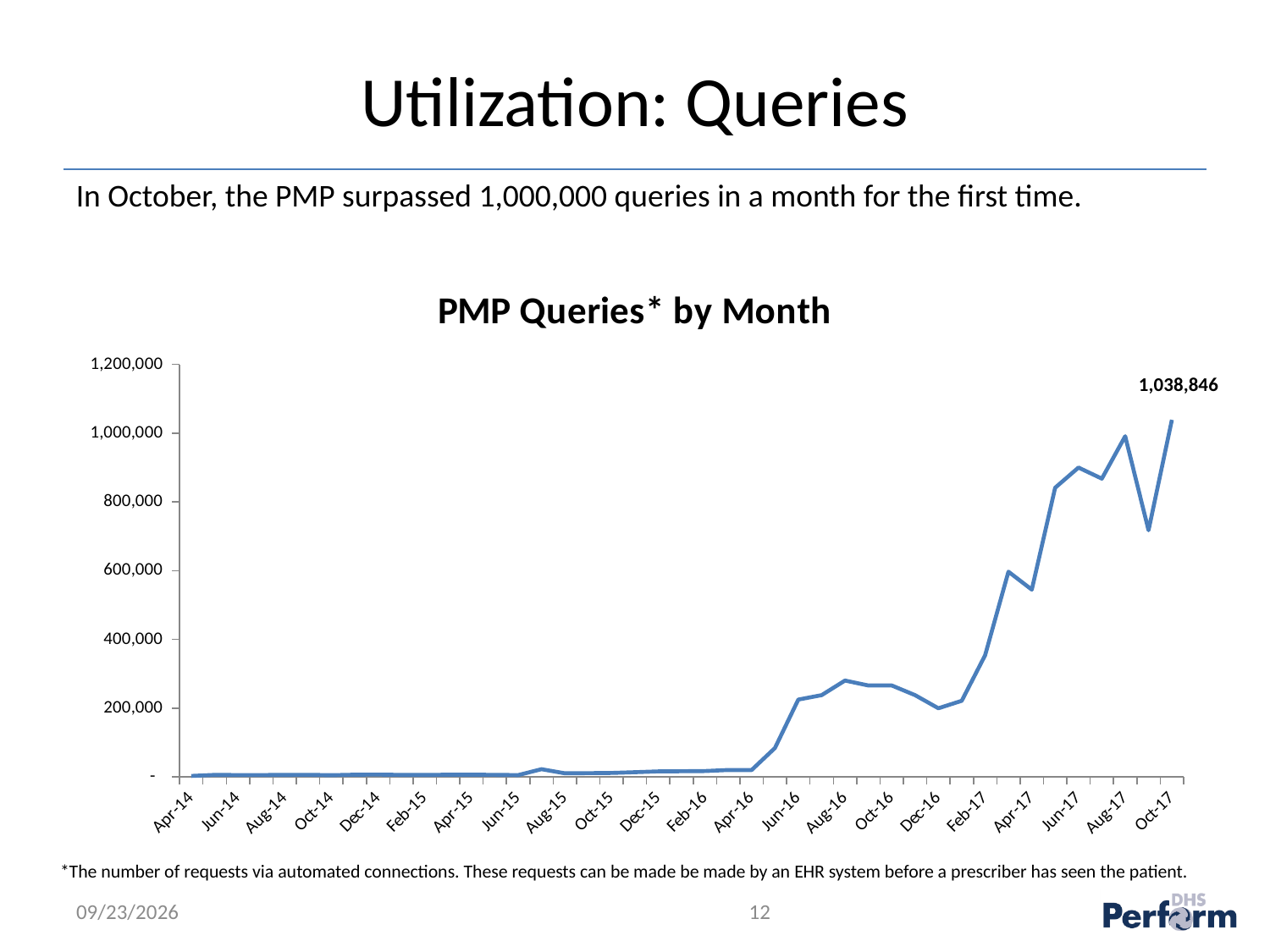
Is the value for Aug-17 greater or less than 800,000? greater Is the value for Sep-17 greater or less than 800,000? less Is the value for Dec-16 greater or less than 400,000? less What is the value of PMP queries for Oct-17? 1,038,846 What is the title of the chart? PMP Queries* by Month Which month has the highest number of PMP queries? Oct-17 What kind of chart is shown on the slide? Line chart What is the highest value shown on the y axis? 1,200,000 Which month has the larger value, Aug-17 or Sep-17? Aug-17 Do PMP queries generally rise or fall from Apr-14 to Oct-17? Rise